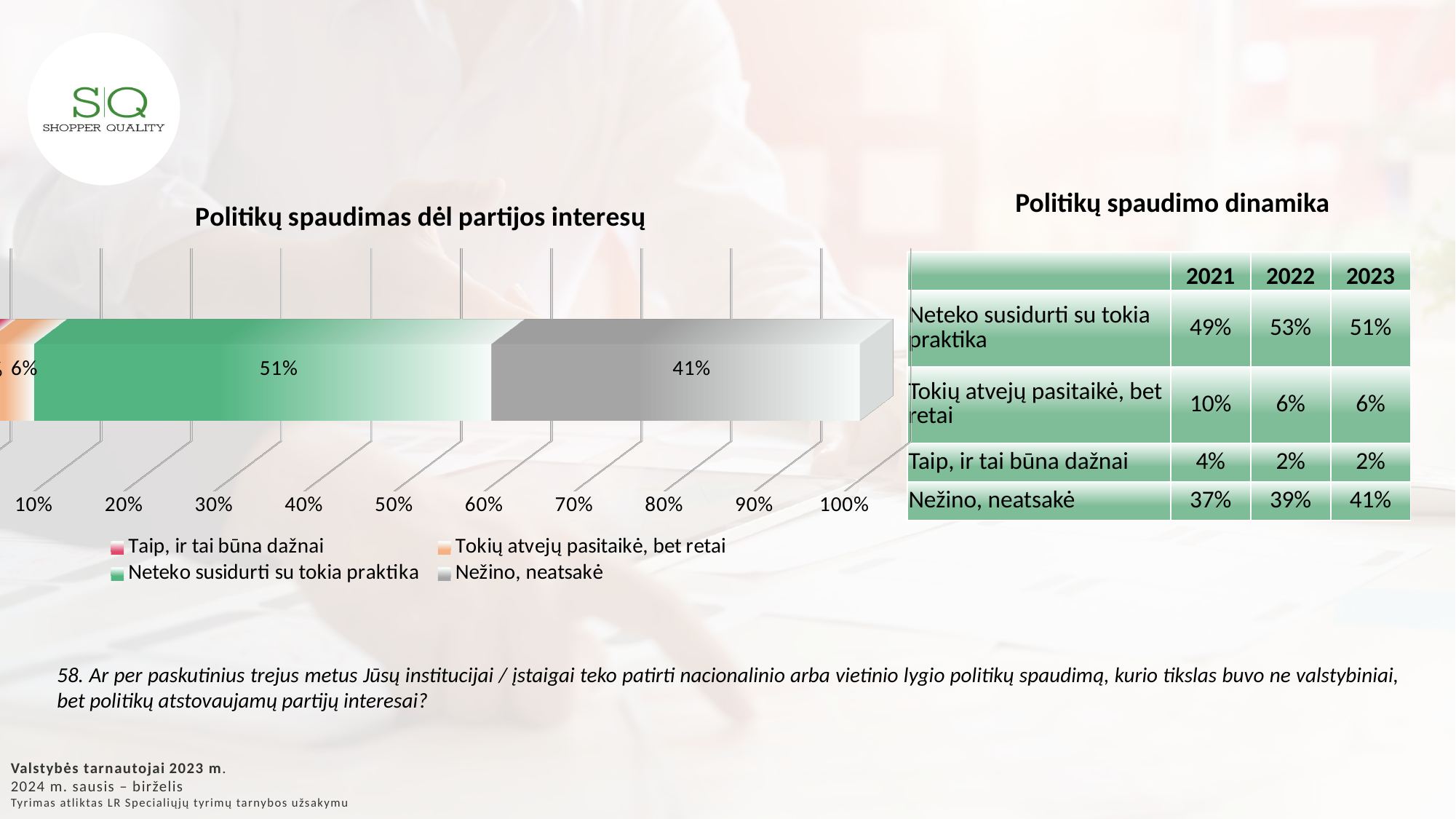
What is the value for 'Nežino, neatsakė' in the chart? 41% What is the title of the chart? Politikų spaudimas dėl partijos interesų What is the value for 'Neteko susidurti su tokia praktika' in the chart? 51% What colour represents 'Neteko susidurti su tokia praktika' in the chart? Green What is the value for 'Tokių atvejų pasitaikė, bet retai' in the chart? 6% Is the value for 'Nežino, neatsakė' greater or less than 30%? greater What is the difference between 'Neteko susidurti su tokia praktika' and 'Tokių atvejų pasitaikė, bet retai'? 45 percentage points Which segment of the bar has the highest value? Neteko susidurti su tokia praktika What is the difference between 'Neteko susidurti su tokia praktika' and 'Nežino, neatsakė'? 10 percentage points How many series does the chart legend list? 4 Which is larger, 'Neteko susidurti su tokia praktika' or 'Nežino, neatsakė'? Neteko susidurti su tokia praktika What kind of chart is shown on the slide? Stacked bar chart